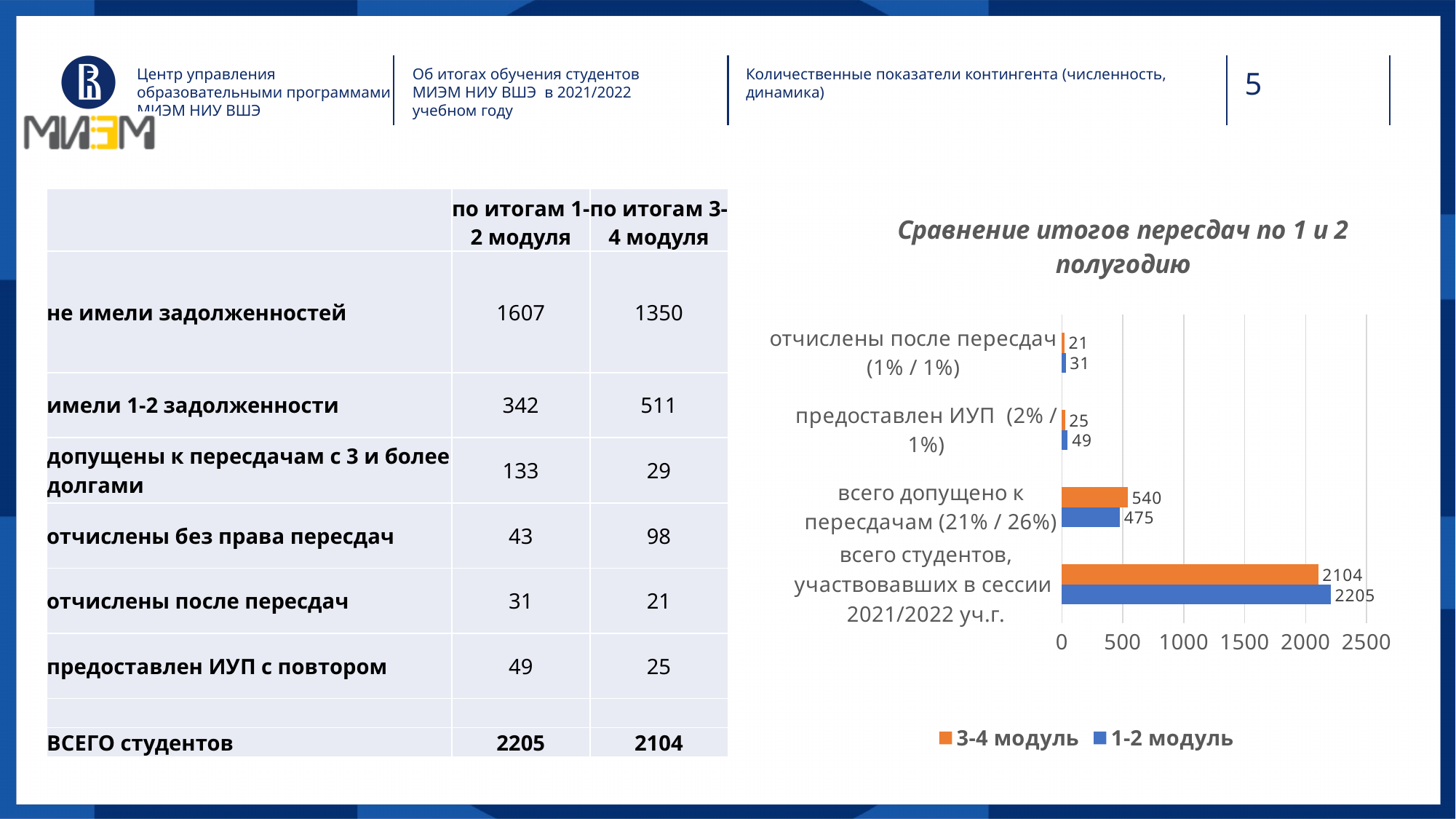
What is the difference between the '3-4 модуль' and '1-2 модуль' values for 'всего допущено к пересдачам (21% / 26%)'? 65 Which category has the lowest value for the '3-4 модуль' series? отчислены после пересдач (1% / 1%) What is the value for '3-4 модуль' in the category 'отчислены после пересдач (1% / 1%)'? 21 What is the value for '1-2 модуль' in the category 'предоставлен ИУП (2% / 1%)'? 49 What is the value for '3-4 модуль' in the category 'всего допущено к пересдачам (21% / 26%)'? 540 Which colour represents the '3-4 модуль' series in the chart? orange How many series does the chart legend list? 2 In the category 'всего студентов, участвовавших в сессии 2021/2022 уч.г.', which series has the larger value, '3-4 модуль' or '1-2 модуль'? 1-2 модуль What is the value for '1-2 модуль' in the category 'всего студентов, участвовавших в сессии 2021/2022 уч.г.'? 2205 What is the title of the chart? Сравнение итогов пересдач по 1 и 2 полугодию How many categories are shown in the chart? 4 What type of chart is shown on the slide? bar chart